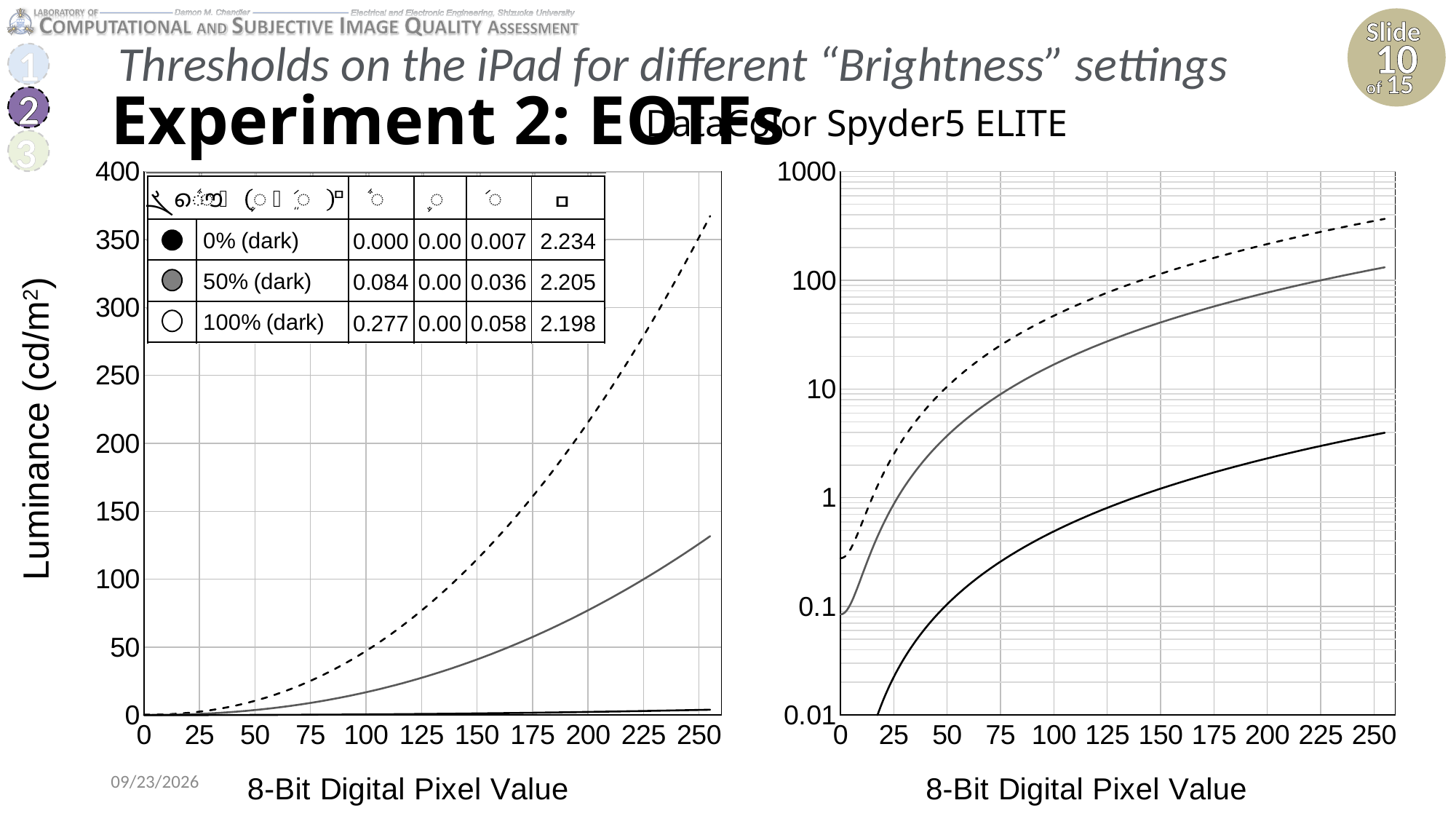
What kind of chart is the left chart on the slide? line chart On the left chart, is the luminance of the 0% (dark) series at pixel value 250 greater or less than 50? less How many series does the legend list on the left chart? 3 On the left chart, what is the label of the y axis? Luminance (cd/m²) On the left chart, which series has the highest luminance at a pixel value of 250? 100% (dark) On the left chart, which series has the lowest luminance at a pixel value of 250? 0% (dark) On the left chart, is the 100% (dark) series or the 50% (dark) series higher at a pixel value of 200? 100% (dark) On the left chart, is the luminance of the 50% (dark) series at pixel value 250 greater or less than 100? greater On the left chart, do the luminance values rise or fall as the pixel value increases? rise On the right chart, is the luminance of the 0% (dark) series at pixel value 250 greater or less than 10? less On the left chart, what is the label of the x axis? 8-Bit Digital Pixel Value